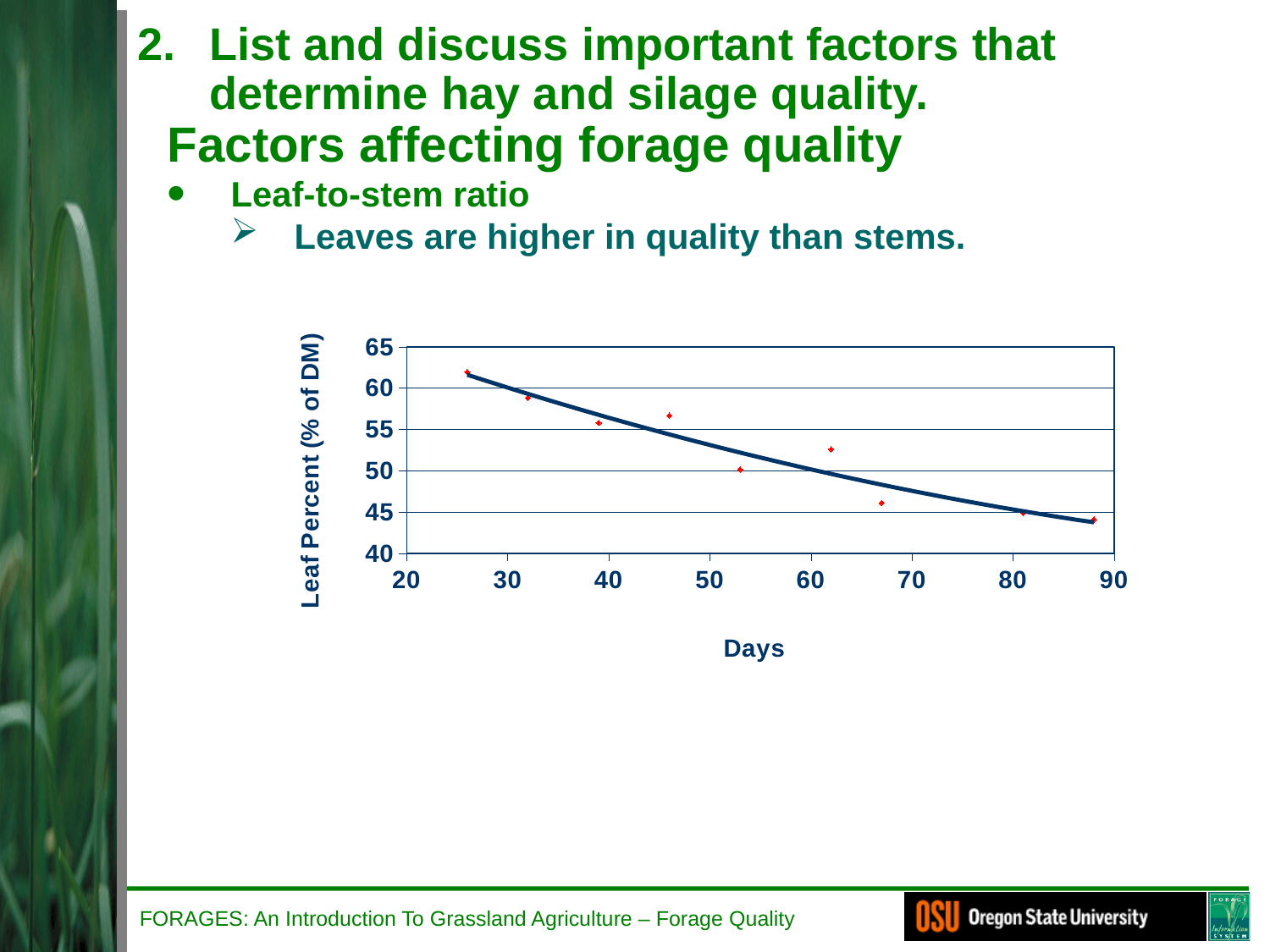
Is the leaf percent value for the point at about 62 days greater or less than 55? less What is the label of the x axis of the chart? Days How many data points are plotted on the chart? 9 As the number of days increases along the x axis, does leaf percent rise or fall? fall What kind of chart is shown on the slide? scatter plot Is the leaf percent value for the point at about 39 days greater or less than 55? greater Is the leaf percent value for the point at about 26 days greater or less than 60? greater What is the label of the y axis of the chart? Leaf Percent (% of DM)